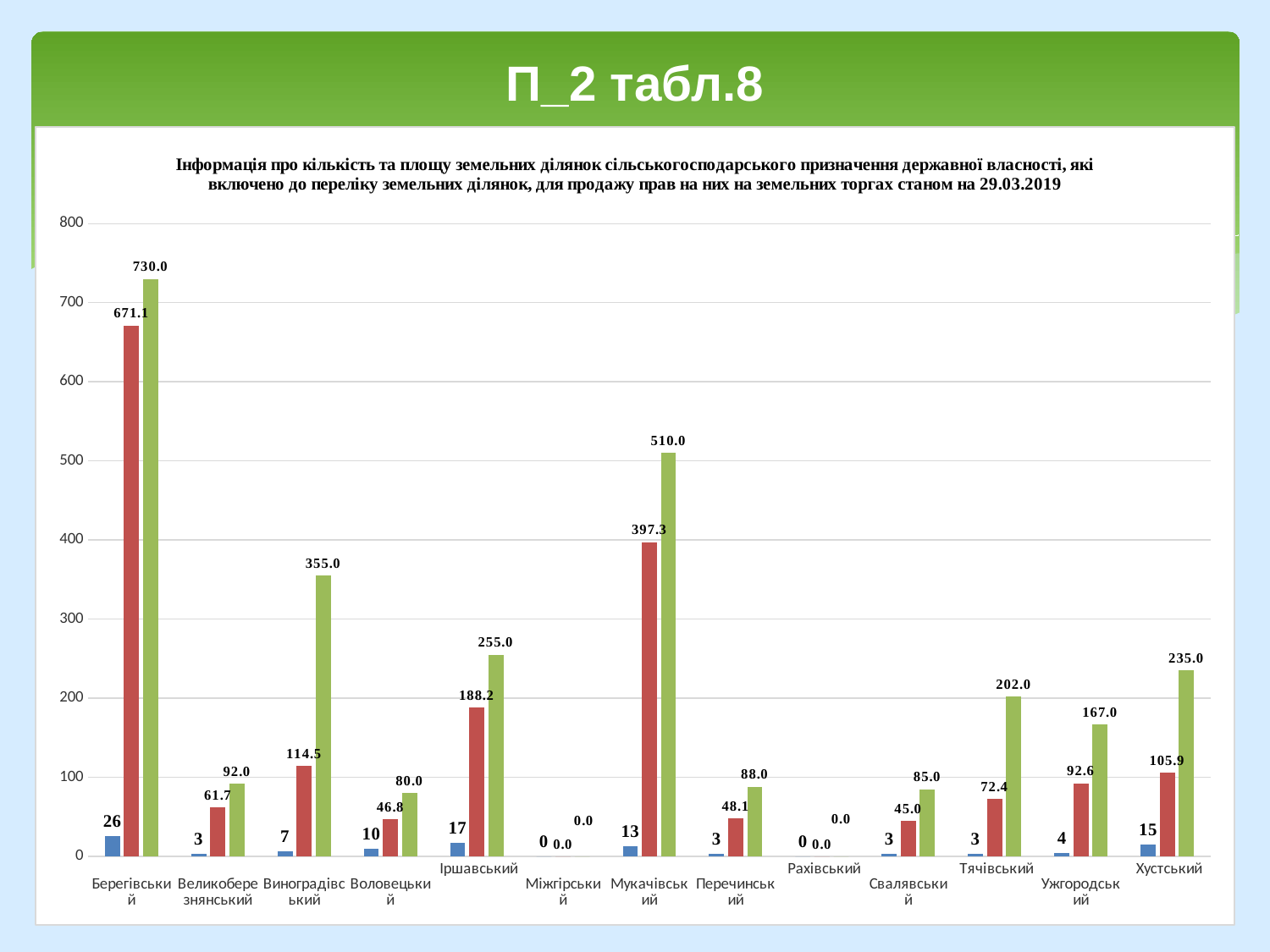
What is the value of the red bar for Мукачівський? 397.3 Which is larger, the green bar for Виноградівський or the green bar for Хустський? Виноградівський Which category has the highest green bar? Берегівський Which category has the highest blue bar? Берегівський What kind of chart is shown on the slide? bar chart What is the value of the green bar for Берегівський? 730.0 Is the value of the red bar for Берегівський greater or less than 600? greater What is the value of the red bar for Тячівський? 72.4 How many categories are shown on the x axis? 13 What is the value of the green bar for Ужгородський? 167.0 What is the value of the blue bar for Іршавський? 17 What is the difference between the green bar and the red bar for Мукачівський? 112.7